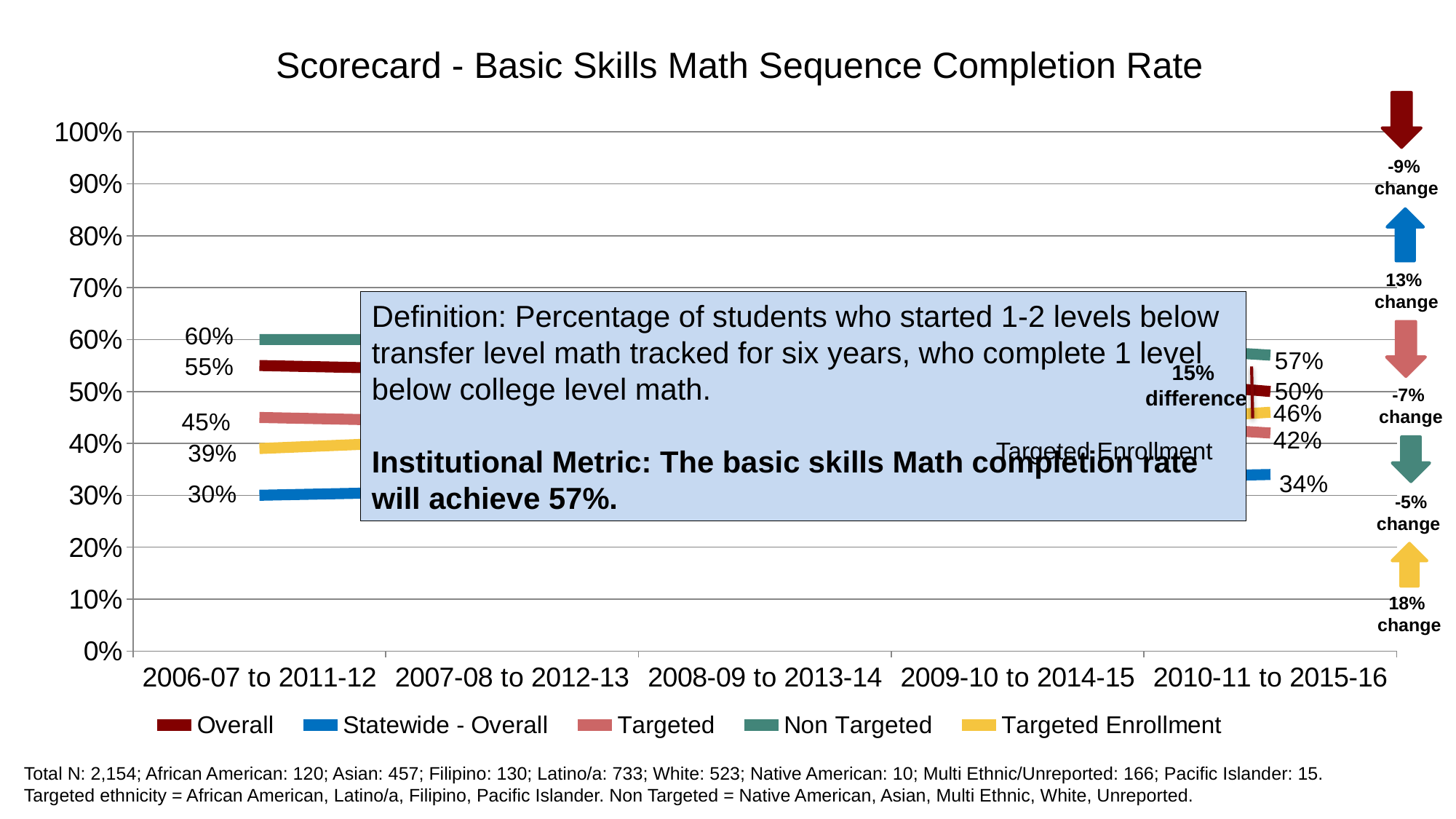
What type of chart is shown on the slide? line chart Which series has the lowest value for the 2010-11 to 2015-16 cohort? Statewide - Overall Which series has the highest value for the 2006-07 to 2011-12 cohort? Non Targeted What is the Non Targeted completion rate for the 2010-11 to 2015-16 cohort? 57% What is the Targeted Enrollment value for the 2010-11 to 2015-16 cohort? 46% What is the Overall completion rate for the 2006-07 to 2011-12 cohort? 55% Which is larger for the 2010-11 to 2015-16 cohort: the Targeted rate or the Targeted Enrollment value? Targeted Enrollment What is the Statewide - Overall completion rate for the 2006-07 to 2011-12 cohort? 30% How many series does the legend list? 5 What is the difference between the Overall rate for 2006-07 to 2011-12 (55%) and for 2010-11 to 2015-16 (50%)? 5% What is the title of the chart? Scorecard - Basic Skills Math Sequence Completion Rate How many cohort periods are shown on the x axis? 5